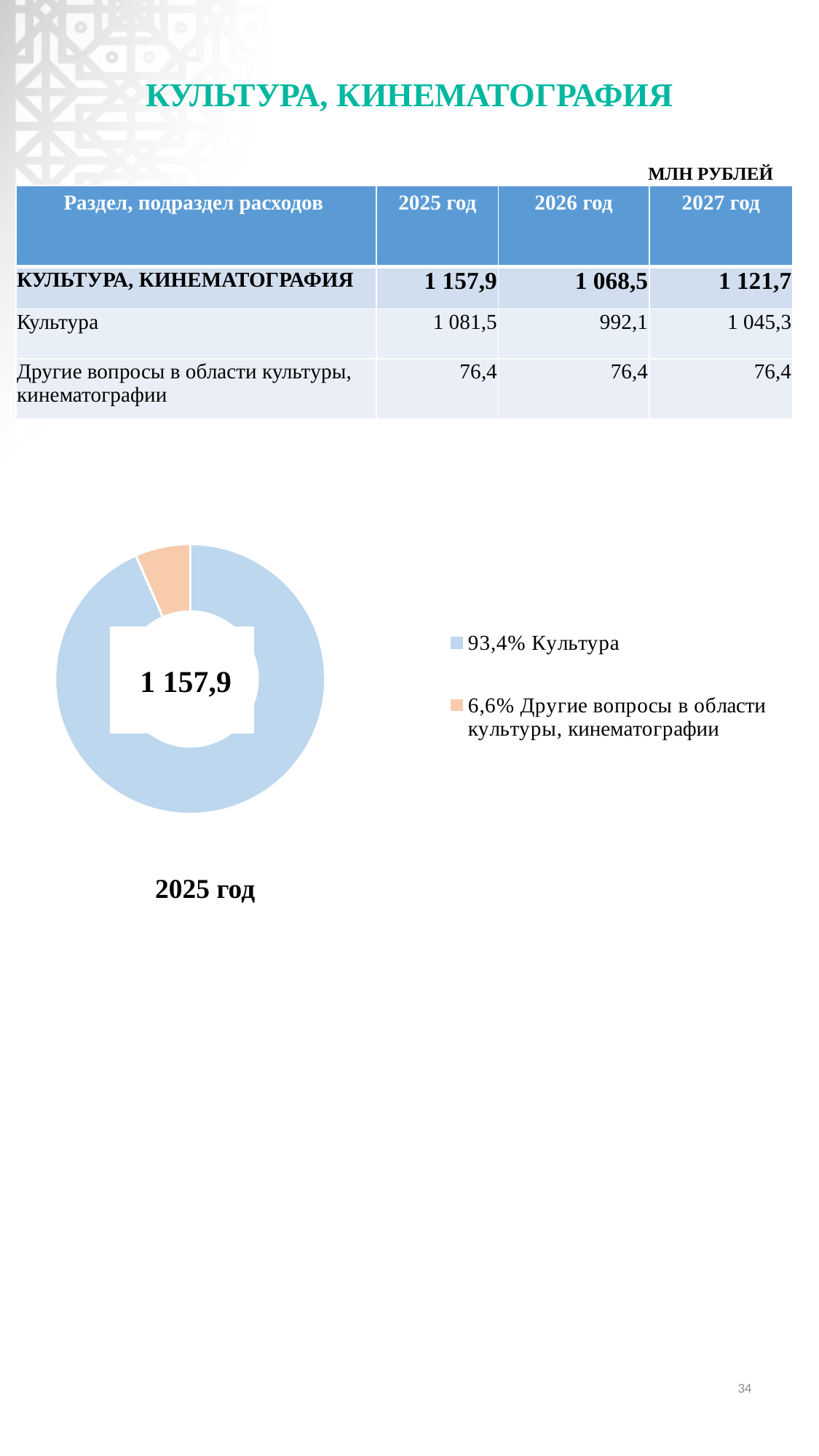
How many entries does the legend of the doughnut chart list? 2 How many slices does the doughnut chart have? 2 What colour is the Культура slice in the doughnut chart? light blue Which is larger in the doughnut chart: the Культура slice or the Другие вопросы в области культуры, кинематографии slice? Культура Which year does the doughnut chart represent? 2025 год Which slice of the doughnut chart is the largest? Культура Which slice of the doughnut chart is the smallest? Другие вопросы в области культуры, кинематографии What share of the doughnut chart does Другие вопросы в области культуры, кинематографии account for? 6,6% What kind of chart is shown on the slide? doughnut (pie) chart What total value is printed in the centre of the doughnut chart? 1 157,9 What share of the doughnut chart does Культура account for? 93,4% What is the difference in percentage points between the Культура slice and the Другие вопросы в области культуры, кинематографии slice? 86,8